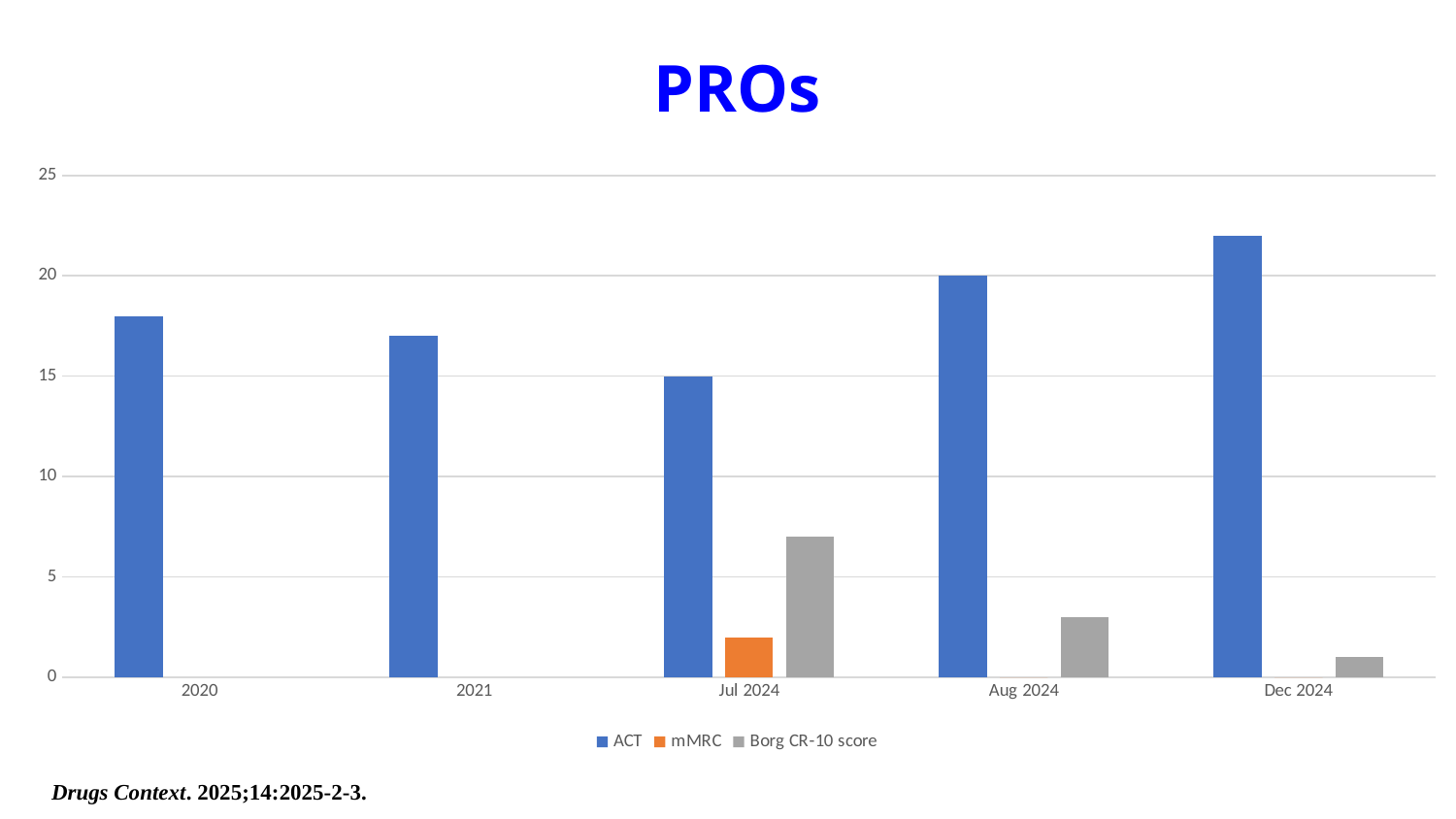
What is the title of the chart? PROs What is the ACT value for Jul 2024? 15 How many categories are shown on the x axis? 5 What is the ACT value for Aug 2024? 20 Is the Borg CR-10 score for Jul 2024 greater or less than 5? greater How many series does the legend list? 3 Which category has the lowest ACT value? Jul 2024 Which category has the highest ACT value? Dec 2024 What kind of chart is shown on the slide? bar chart Which is larger, the Borg CR-10 score for Aug 2024 or for Dec 2024? Aug 2024 Is the ACT value for Dec 2024 greater or less than 20? greater Which category is the only one with an mMRC bar? Jul 2024